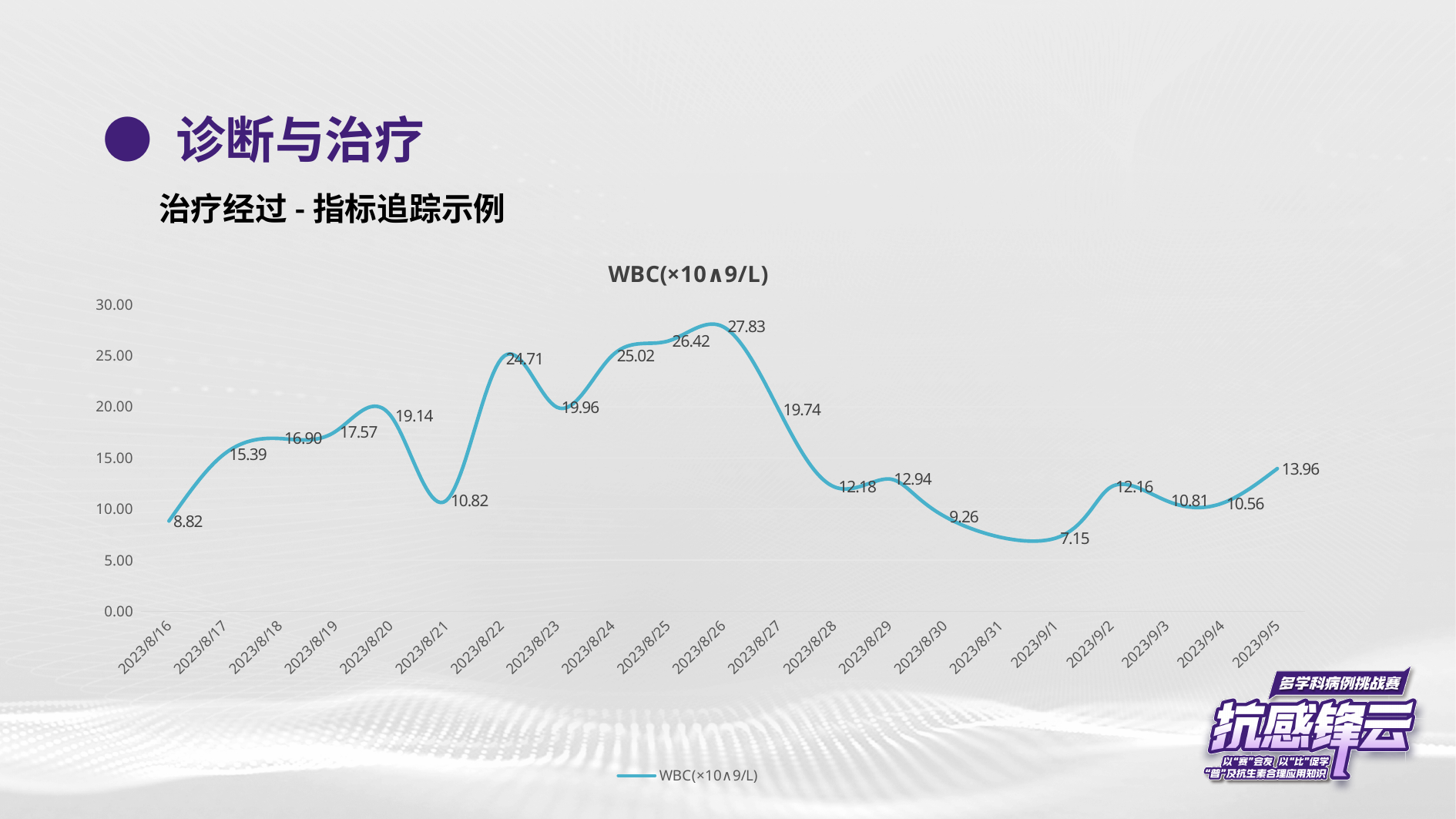
What is the title of the chart? WBC(×10∧9/L) How many dates are shown on the x axis? 21 What is the WBC value on 2023/9/5? 13.96 What kind of chart is shown on the slide? line chart What is the WBC value on 2023/8/16? 8.82 How many series does the legend list? 1 Does the WBC value rise or fall from 2023/8/16 to 2023/8/20? rise What is the difference between the WBC value on 2023/8/26 and on 2023/8/16? 19.01 On which date is the WBC value highest? 2023/8/26 Which date has the larger WBC value, 2023/8/23 or 2023/8/24? 2023/8/24 What is the WBC value on 2023/8/22? 24.71 What is the lowest WBC value labelled on the chart? 7.15